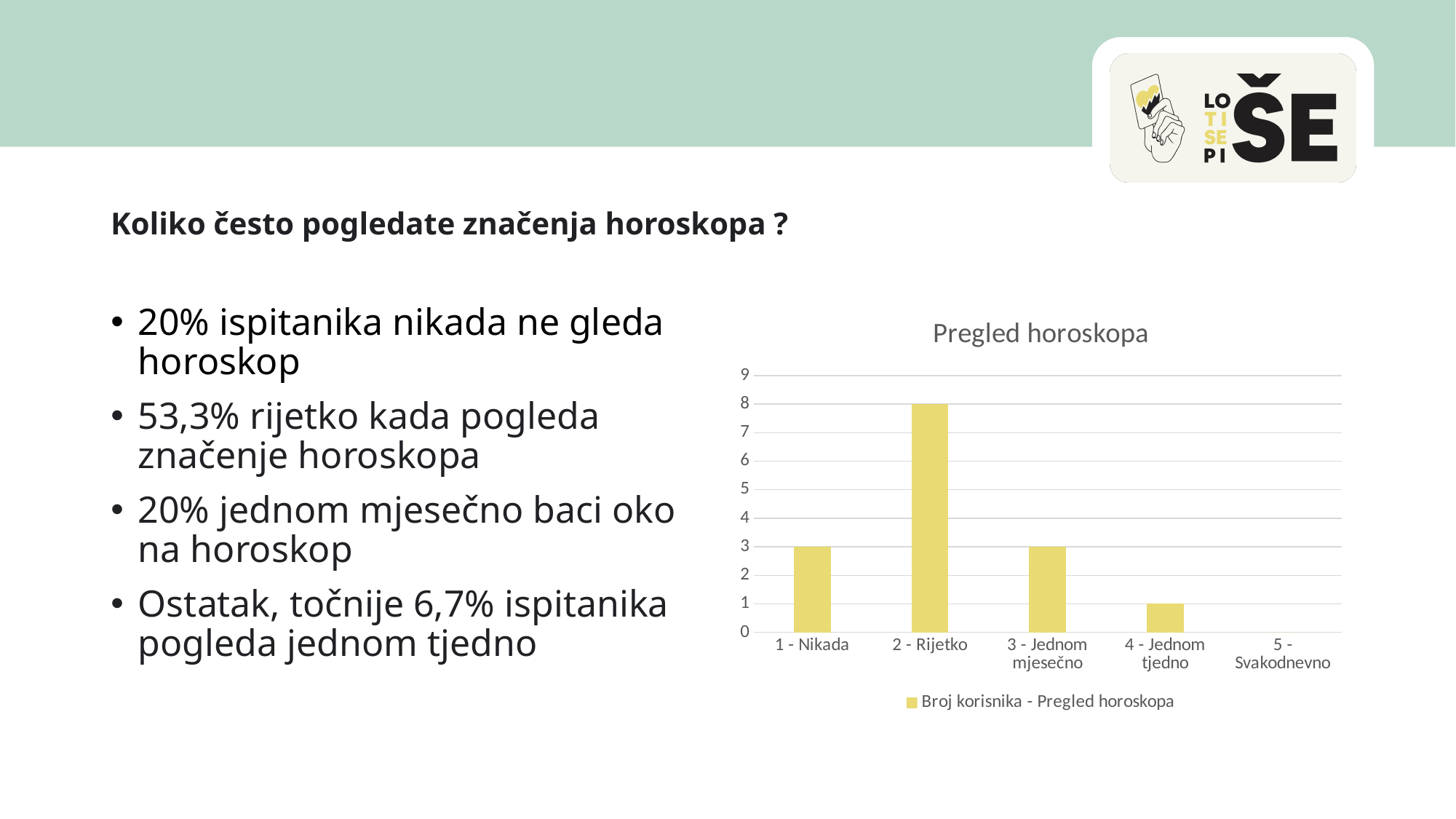
What is the value for "1 - Nikada"? 3 How many series does the chart legend list? 1 What is the value for "2 - Rijetko"? 8 What is the value for "4 - Jednom tjedno"? 1 How many categories are shown on the x axis of the chart? 5 Which category has the highest value? 2 - Rijetko Is the value for "2 - Rijetko" greater or less than 5? greater What is the difference between the values for "2 - Rijetko" and "3 - Jednom mjesečno"? 5 What type of chart is shown on the slide? bar chart What is the title of the chart? Pregled horoskopa Which category has the lowest value? 5 - Svakodnevno Which is larger, the value for "1 - Nikada" or the value for "4 - Jednom tjedno"? 1 - Nikada